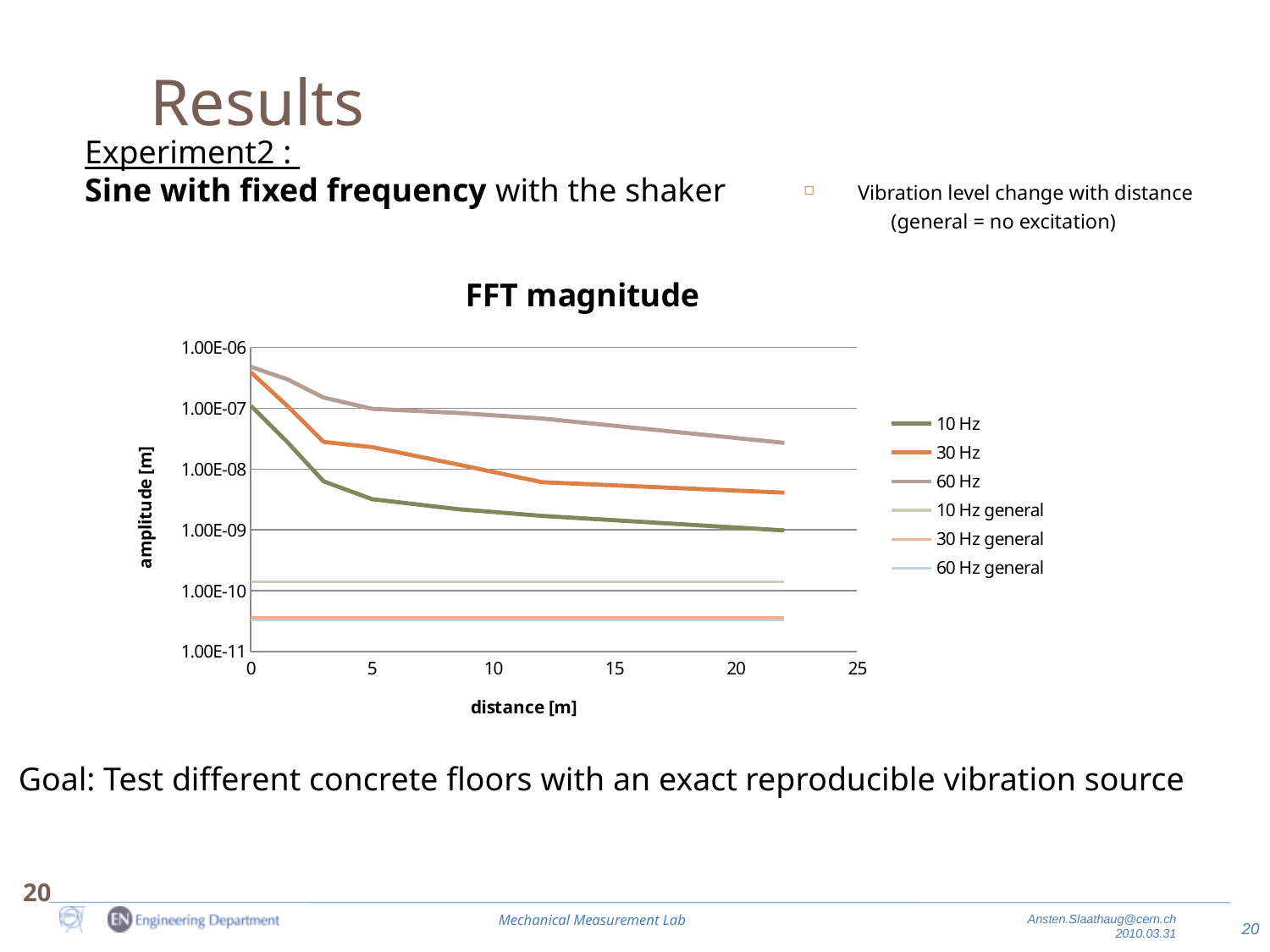
What kind of chart is shown on the slide? line chart Does the amplitude of the 30 Hz series rise or fall as distance increases? fall Which series has the highest amplitude at distance 0 m? 60 Hz Is the amplitude of the 30 Hz series at distance 5 m greater or less than 1.00E-08? greater Is the amplitude of the 60 Hz series at distance 0 m greater or less than 1.00E-07? greater How many series does the legend of the FFT magnitude chart list? 6 Is the amplitude of the 30 Hz general series greater or less than 1.00E-10? less What is the title of the chart? FFT magnitude What is the label of the x axis of the chart? distance [m] At a distance of 20 m, which series has the larger amplitude, 30 Hz or 10 Hz? 30 Hz At a distance of 10 m, which series has the larger amplitude, 60 Hz or 10 Hz? 60 Hz